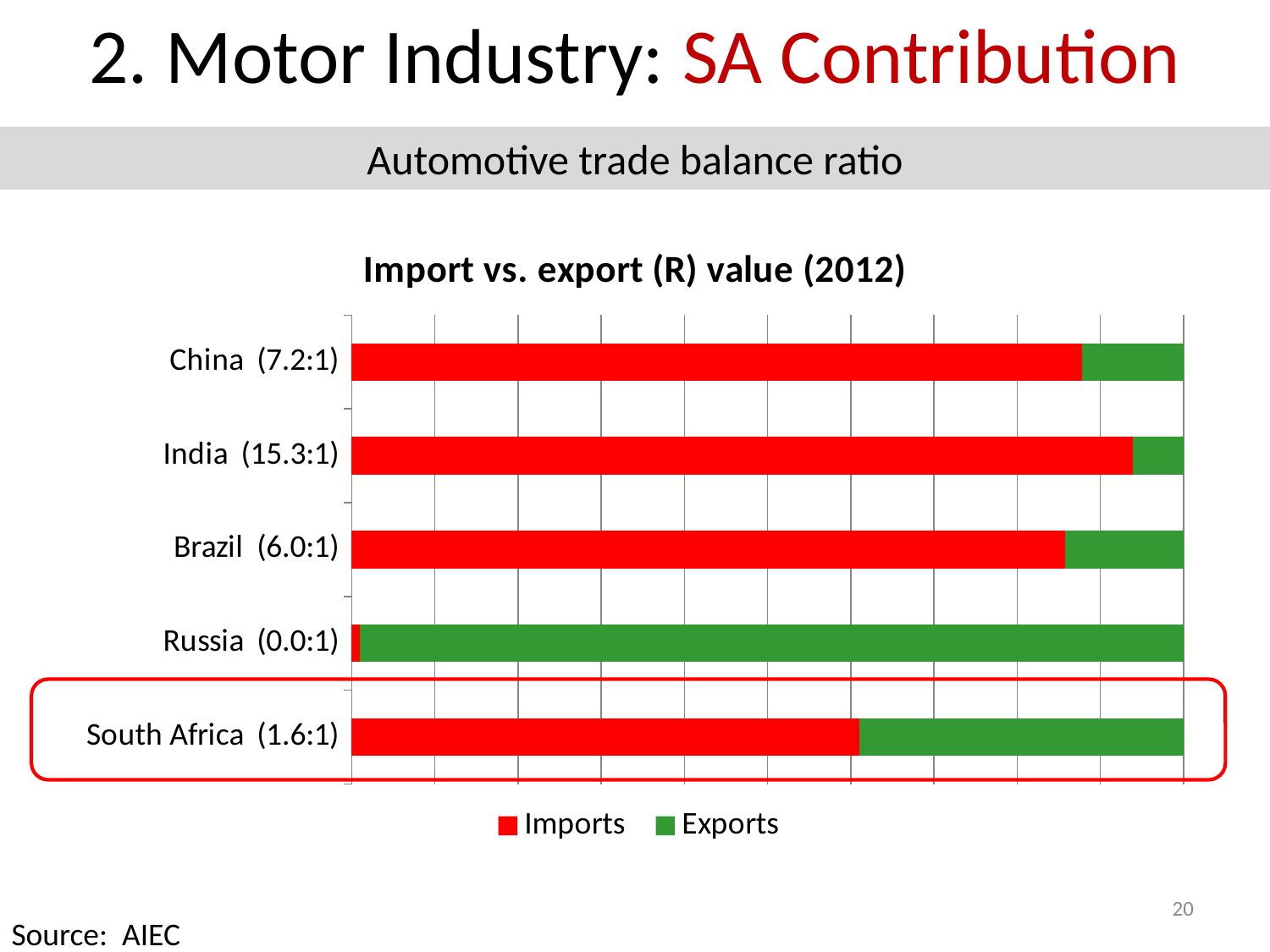
For Russia, which is larger, the Imports portion or the Exports portion of the bar? Exports Which country has the largest Exports share of its bar? Russia For South Africa, which is larger, the Imports portion or the Exports portion of the bar? Imports What kind of chart is shown on the slide? Stacked bar chart Which country has the largest Imports share of its bar? India How many countries are plotted in the chart? 5 What trade balance ratio is printed next to India's label? 15.3:1 What is the title of the chart? Import vs. export (R) value (2012) What are the two series named in the legend? Imports and Exports How many series does the legend list? 2 Which country has the smallest Imports share of its bar? Russia What trade balance ratio is printed next to South Africa's label? 1.6:1